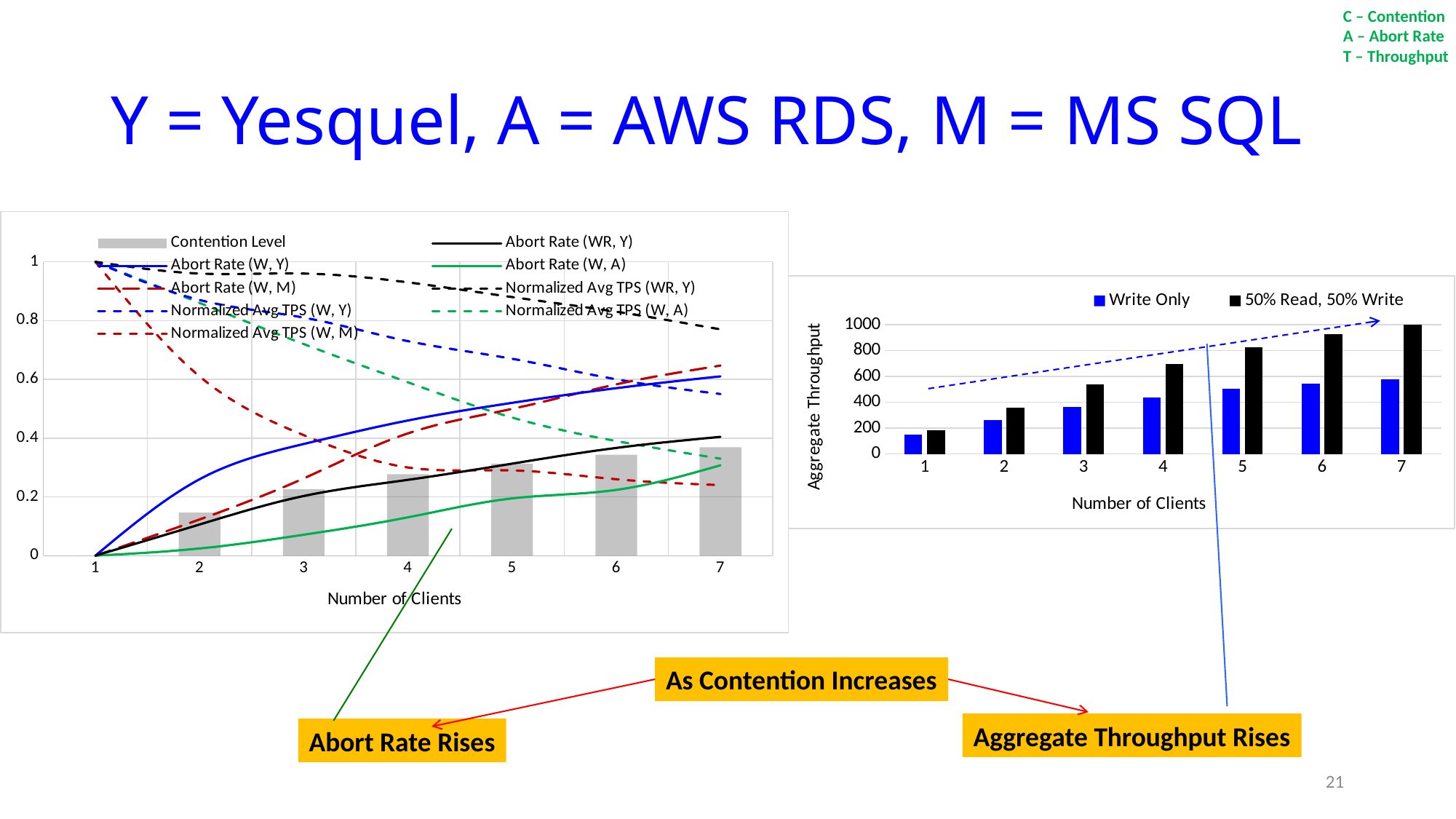
In the left chart, how many entries does the legend list? 9 In the right chart, is the Write Only throughput at 1 client greater or less than 200? less In the left chart, is the Contention Level at 7 clients greater or less than 0.4? less In the right chart, is the 50% Read, 50% Write throughput at 7 clients greater or less than 800? greater In the right chart, how many series does the legend list? 2 In the right chart, does the 50% Read, 50% Write throughput rise or fall as the number of clients increases? rises In the right chart, at 7 clients, which series has the larger aggregate throughput: Write Only or 50% Read, 50% Write? 50% Read, 50% Write What kind of chart is the right chart (Aggregate Throughput)? bar chart In the right chart, how many client counts are shown on the x axis? 7 In the left chart, what is the value of Abort Rate (W, Y) at 1 client? 0 In the right chart, at which number of clients is the 50% Read, 50% Write throughput highest? 7 In the left chart, does Normalized Avg TPS (W, M) rise or fall as the number of clients increases? falls